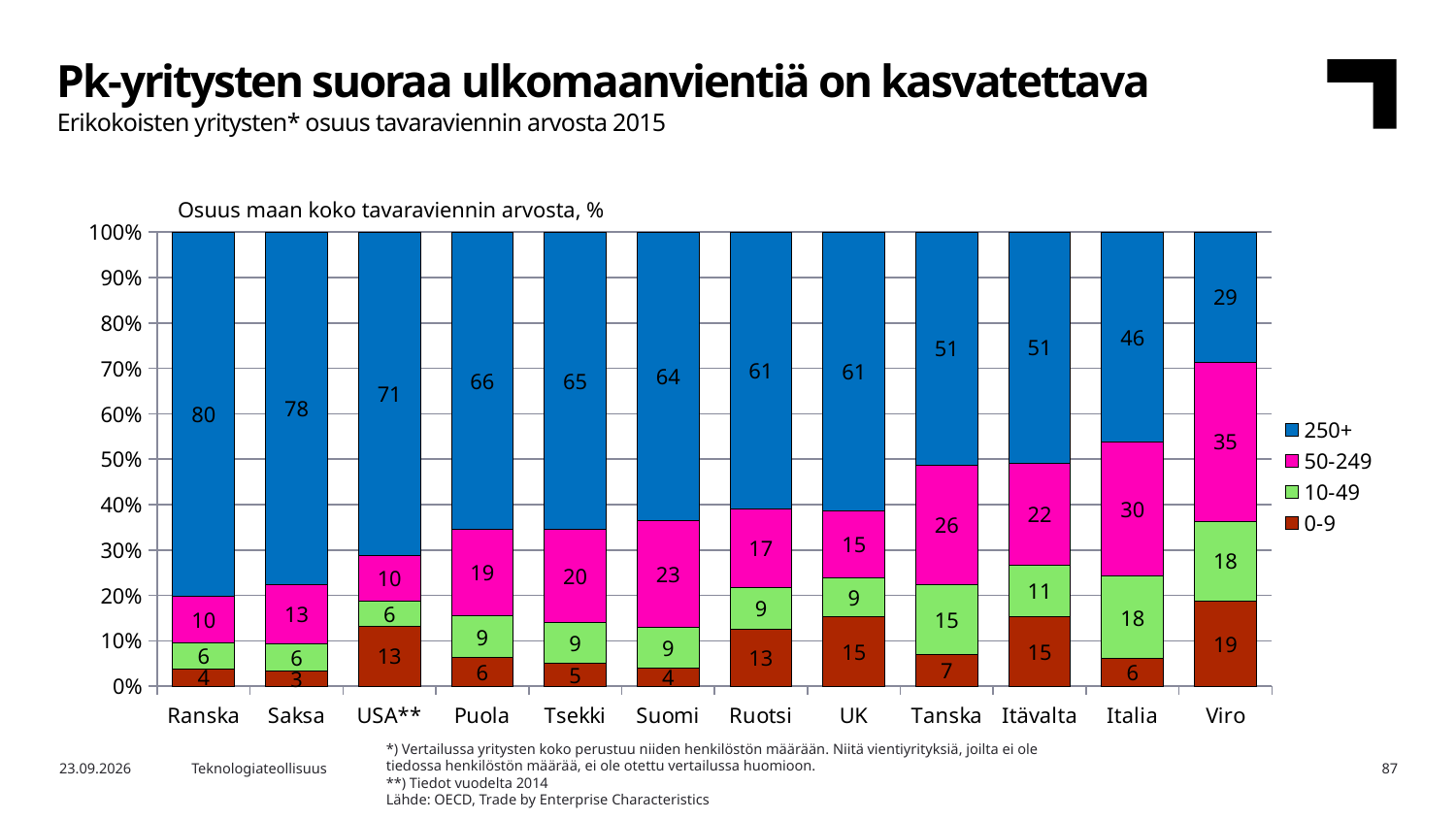
Which country has the lowest value for the 250+ series? Viro What kind of chart is shown on the slide? Stacked bar chart Which is larger, the 50-249 value for Italia or the 50-249 value for Tanska? Italia What is the value of the 50-249 series for Viro? 35 What is the value of the 250+ series for Suomi? 64 What is the difference between the 250+ values for Ranska and Viro? 51 Do the 250+ values rise or fall moving from Ranska to Viro along the x axis? Fall How many series does the legend list? 4 What is the value of the 0-9 series for USA**? 13 How many countries are shown on the x axis? 12 Which country has the highest value for the 250+ series? Ranska What is the title printed above the chart's plot area? Osuus maan koko tavaraviennin arvosta, %